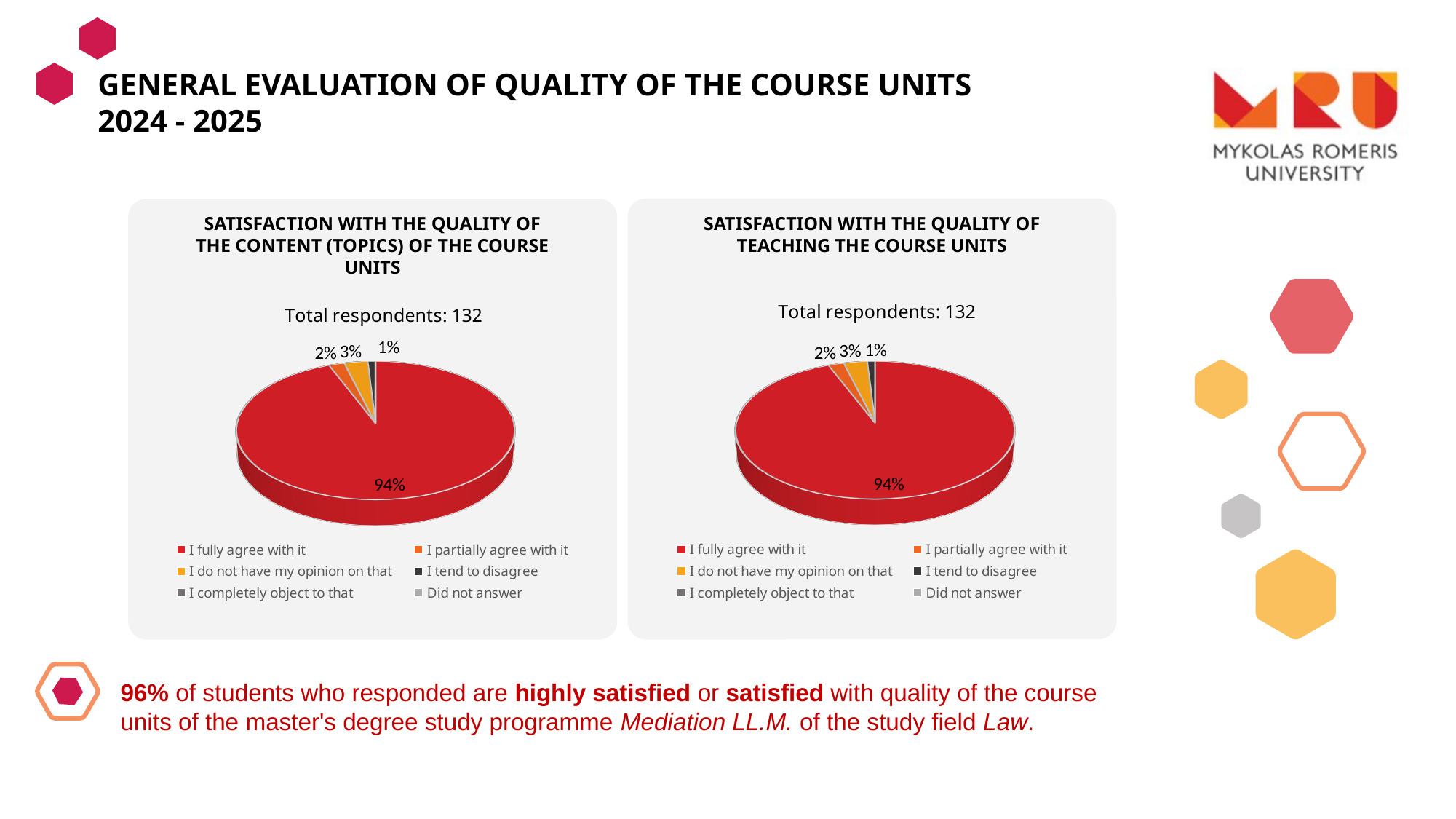
In the 'Satisfaction with the quality of teaching the course units' chart, what percentage of respondents chose 'I tend to disagree'? 1% In the 'Satisfaction with the quality of teaching the course units' chart, what percentage of respondents chose 'I partially agree with it'? 2% In the 'Satisfaction with the quality of the content (topics) of the course units' chart, what percentage of respondents chose 'I fully agree with it'? 94% In the 'Satisfaction with the quality of teaching the course units' chart, which is larger: the share for 'I partially agree with it' or 'I do not have my opinion on that'? I do not have my opinion on that How many total respondents are reported for the 'Satisfaction with the quality of the content (topics) of the course units' chart? 132 In the 'Satisfaction with the quality of teaching the course units' chart, what percentage of respondents chose 'I fully agree with it'? 94% In the 'Satisfaction with the quality of the content (topics) of the course units' chart, what colour represents 'I fully agree with it'? Red What type of chart is used in the 'Satisfaction with the quality of the content (topics) of the course units' chart? Pie chart How many entries does the legend of the 'Satisfaction with the quality of teaching the course units' chart list? 6 In the 'Satisfaction with the quality of the content (topics) of the course units' chart, what is the difference between the share for 'I fully agree with it' and the share for 'I do not have my opinion on that'? 91% Which response category has the largest share in the 'Satisfaction with the quality of the content (topics) of the course units' chart? I fully agree with it In the 'Satisfaction with the quality of the content (topics) of the course units' chart, what percentage of respondents chose 'I do not have my opinion on that'? 3%